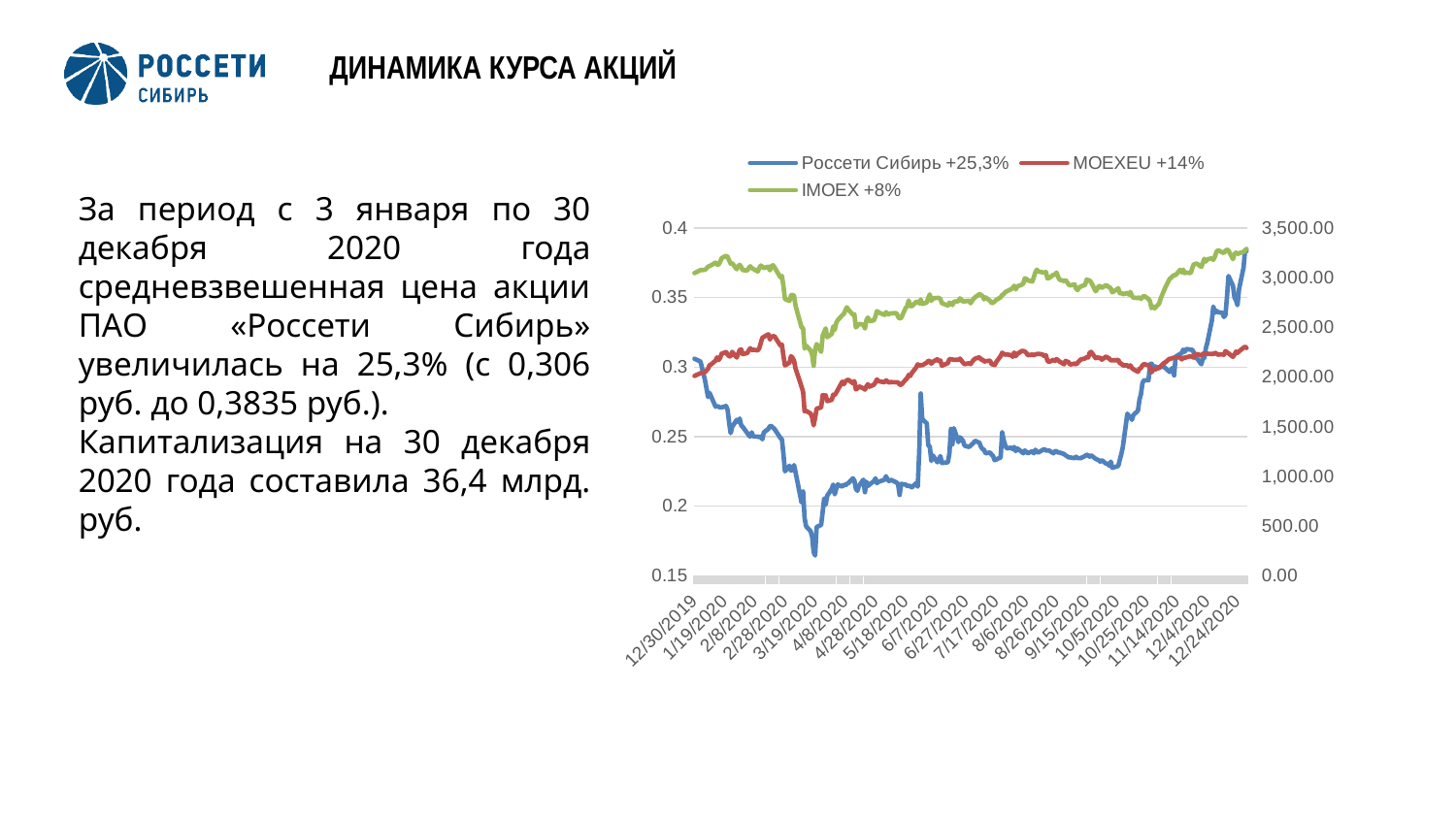
Is the value of the Россети Сибирь line at its lowest point around 3/19/2020 greater or less than 0.2? less What percentage change is shown in the legend for Россети Сибирь? +25,3% What percentage change is shown in the legend for IMOEX? +8% Is the value of the Россети Сибирь line around 10/5/2020 greater or less than 0.25? less How many series does the chart legend list? 3 Which series in the legend shows the smallest percentage change? IMOEX +8% Which series in the legend shows the largest percentage change? Россети Сибирь +25,3% What kind of chart is shown on the slide? line chart Is the Россети Сибирь line higher at the end of the period (12/24/2020) or at the start (12/30/2019)? at the end (12/24/2020) Does the Россети Сибирь line rise or fall between 10/5/2020 and 12/24/2020? rise What is the highest value shown on the left vertical axis? 0.4